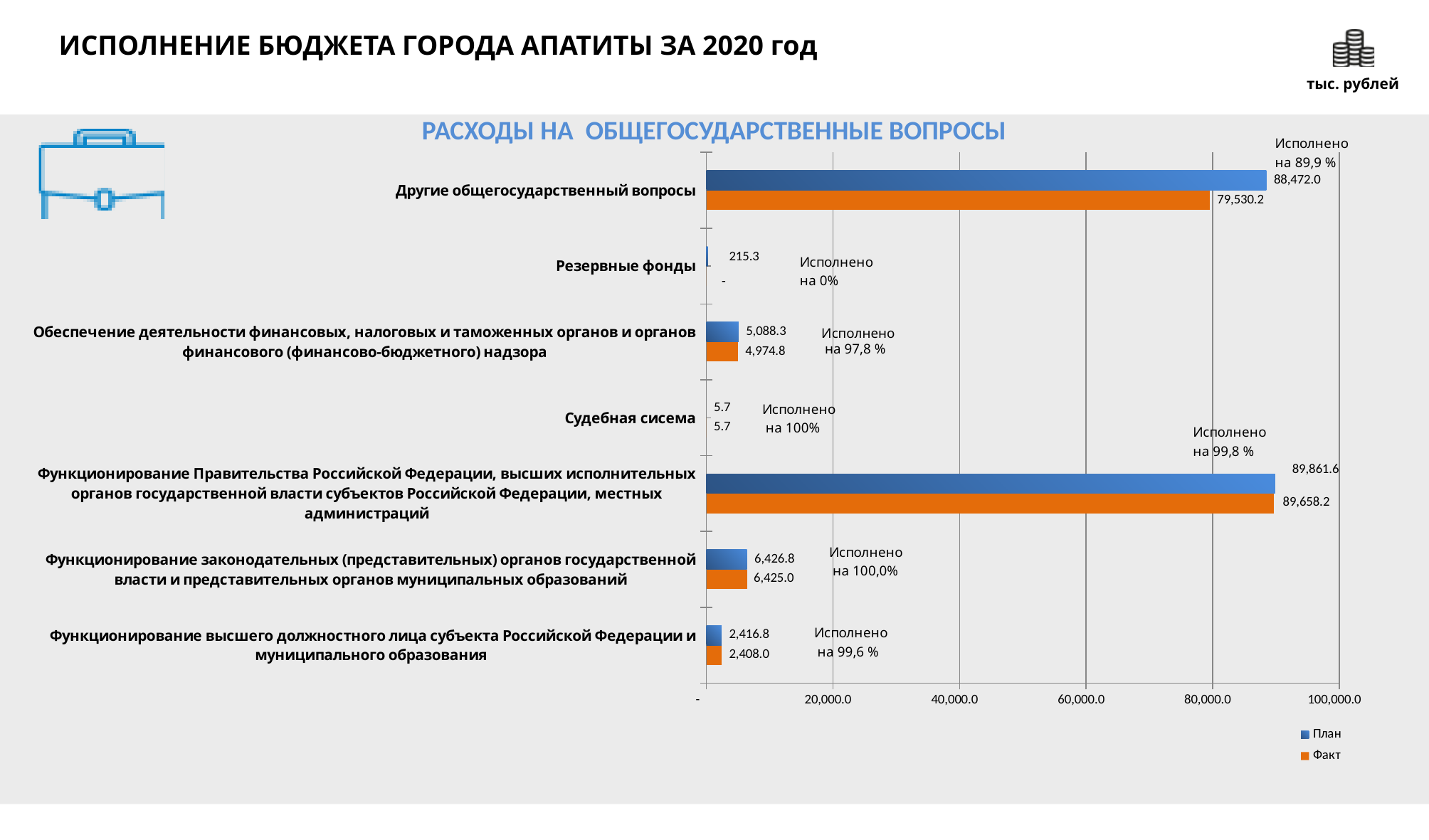
What is the Факт value for 'Функционирование высшего должностного лица субъекта Российской Федерации и муниципального образования'? 2,408.0 Which is larger for 'Функционирование законодательных (представительных) органов государственной власти и представительных органов муниципальных образований': the План value or the Факт value? План What type of chart is shown on the slide? bar chart How many categories are shown on the chart? 7 What is the Факт value for 'Обеспечение деятельности финансовых, налоговых и таможенных органов и органов финансового (финансово-бюджетного) надзора'? 4,974.8 What execution percentage is shown for 'Резервные фонды'? 0% What is the План value for 'Другие общегосударственный вопросы'? 88,472.0 What is the difference between the План and Факт values for 'Другие общегосударственный вопросы'? 8,941.8 Is the Факт value for 'Другие общегосударственный вопросы' greater or less than 60,000.0? greater Which category has the highest План value? Функционирование Правительства Российской Федерации, высших исполнительных органов государственной власти субъектов Российской Федерации, местных администраций Which category has the lowest План value? Судебная сисема How many series does the legend list? 2